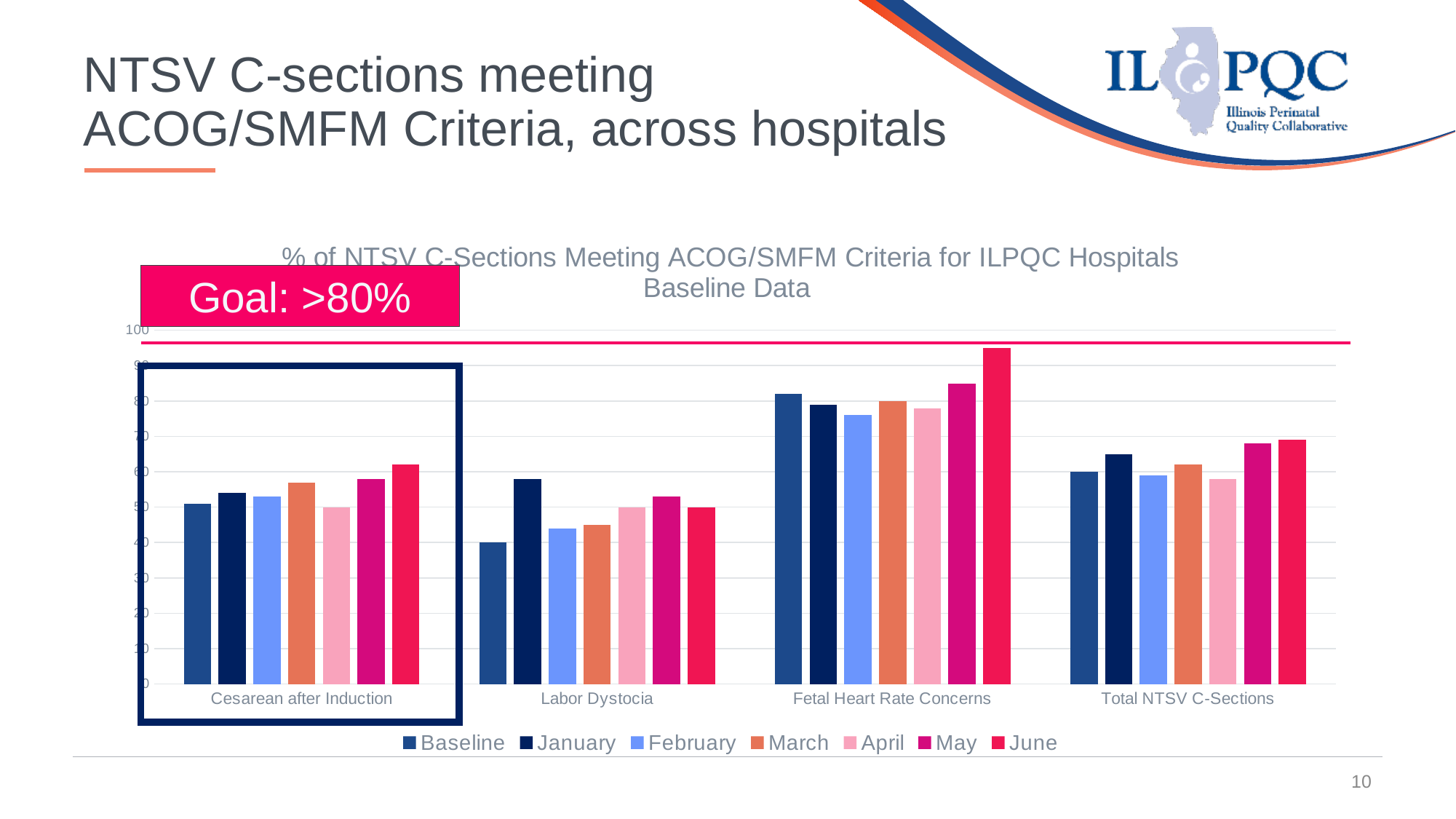
Which is larger: the June value for Fetal Heart Rate Concerns or the June value for Cesarean after Induction? Fetal Heart Rate Concerns Which category has the highest June bar? Fetal Heart Rate Concerns Within the Labor Dystocia category, which series has the highest bar? January Within the Labor Dystocia category, which series has the lowest bar? Baseline How many series does the chart's legend list? 7 Which category is highlighted with a dark outlined box on the chart? Cesarean after Induction How many categories are shown along the x axis of the chart? 4 What kind of chart is shown on the slide? bar chart Is the June value for Fetal Heart Rate Concerns greater or less than 90? greater What goal is stated in the box above the chart? >80% Is the May value for Total NTSV C-Sections greater or less than 60? greater Is the Baseline value for Labor Dystocia greater or less than 50? less